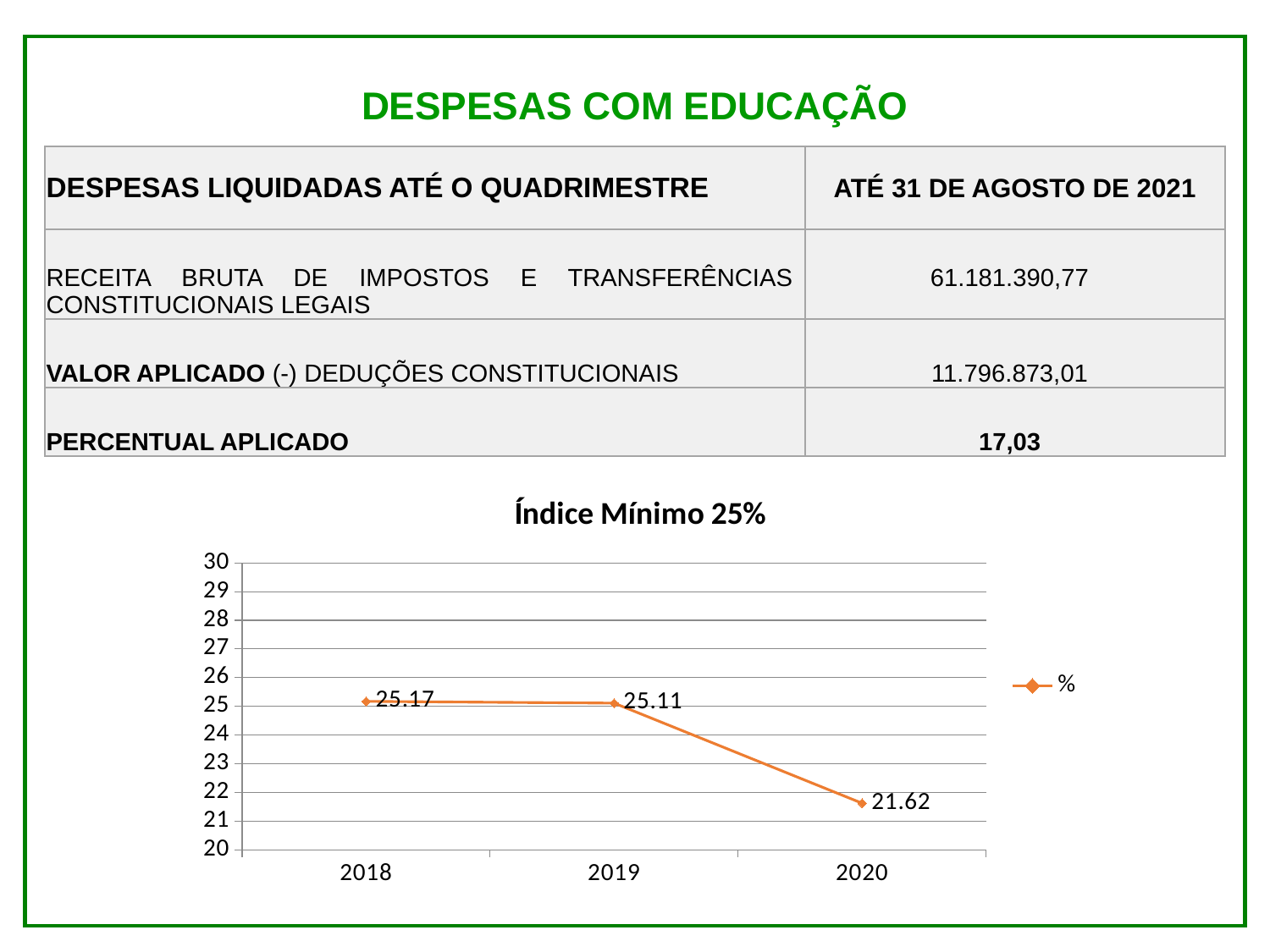
What is the difference between the values for 2018 and 2019? 0.06 How many years are plotted in the chart? 3 Is the value for 2020 greater or less than 25? less What is the difference between the values for 2019 and 2020? 3.49 What is the title of the chart? Índice Mínimo 25% Which year has the lowest value in the chart? 2020 What kind of chart is shown on the slide? line chart What is the value for 2018 in the chart? 25.17 Which is larger, the value for 2019 or the value for 2020? 2019 Which year has the highest value in the chart? 2018 What is the value for 2019 in the chart? 25.11 What is the value for 2020 in the chart? 21.62